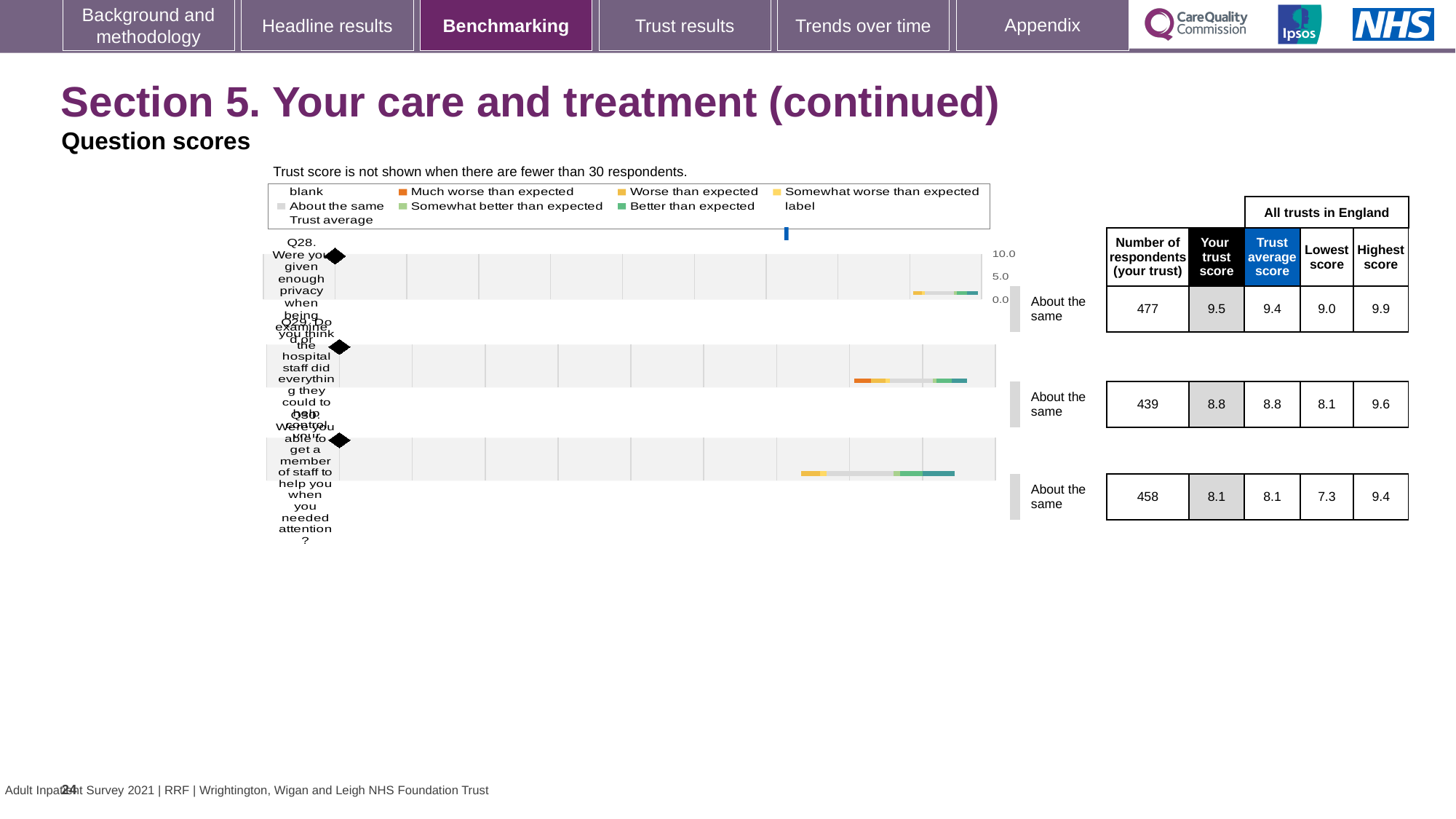
What kind of chart is used to show the question scores on this slide? bar chart What is the lowest score across all trusts in England for Q29? 8.1 What is the 'Your trust score' value for Q28 (Were you given enough privacy when being examined or treated)? 9.5 Which question has the highest 'Your trust score'? Q28 What is the highest score across all trusts in England for Q30? 9.4 For Q28, which is larger: your trust score or the trust average score? Your trust score For Q30, what is the difference between the highest score and the lowest score across all trusts in England? 2.1 Which question has the lowest 'Your trust score'? Q30 What benchmark category label is shown next to each of the three questions in the chart? About the same For Q28, what is the difference between the highest score and the lowest score across all trusts in England? 0.9 How many respondents from your trust answered Q29? 439 How many questions are plotted in the question scores chart? 3